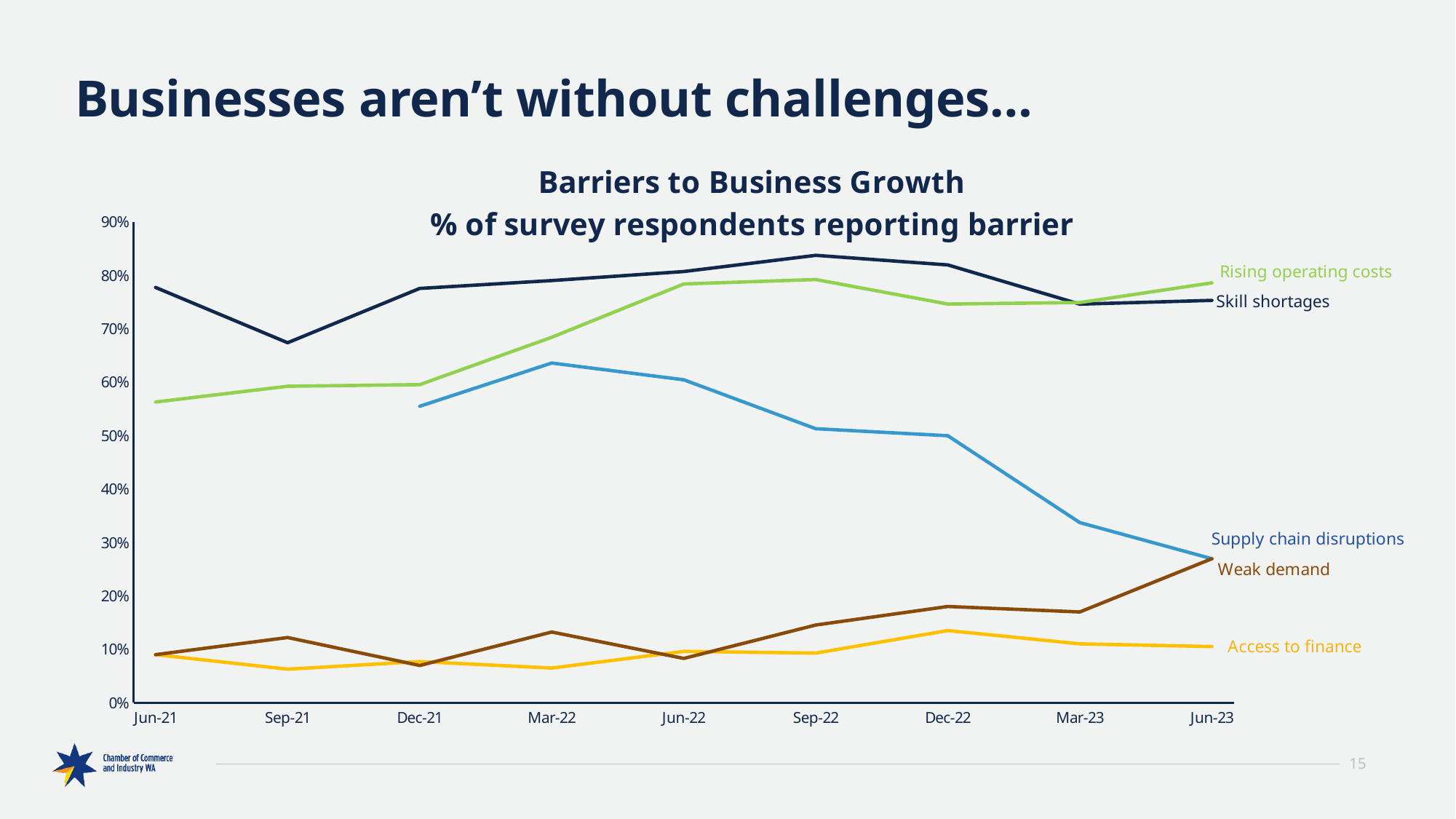
Is the value for Weak demand at Dec-22 greater or less than 20%? less Does the Rising operating costs line rise or fall from Jun-21 to Jun-22? Rises Which barrier has the lowest value at Jun-23? Access to finance How many series (barriers) are plotted on the chart? 5 Which barrier has the highest value at Sep-22? Skill shortages How many time points are shown on the x axis of the chart? 9 Is the value for Rising operating costs at Jun-21 greater or less than 50%? greater At Jun-21, which is higher: Skill shortages or Rising operating costs? Skill shortages Does the Supply chain disruptions line rise or fall from Mar-22 to Jun-23? Falls Is the value for Skill shortages at Sep-22 greater or less than 80%? greater What type of chart is shown on the slide? Line chart